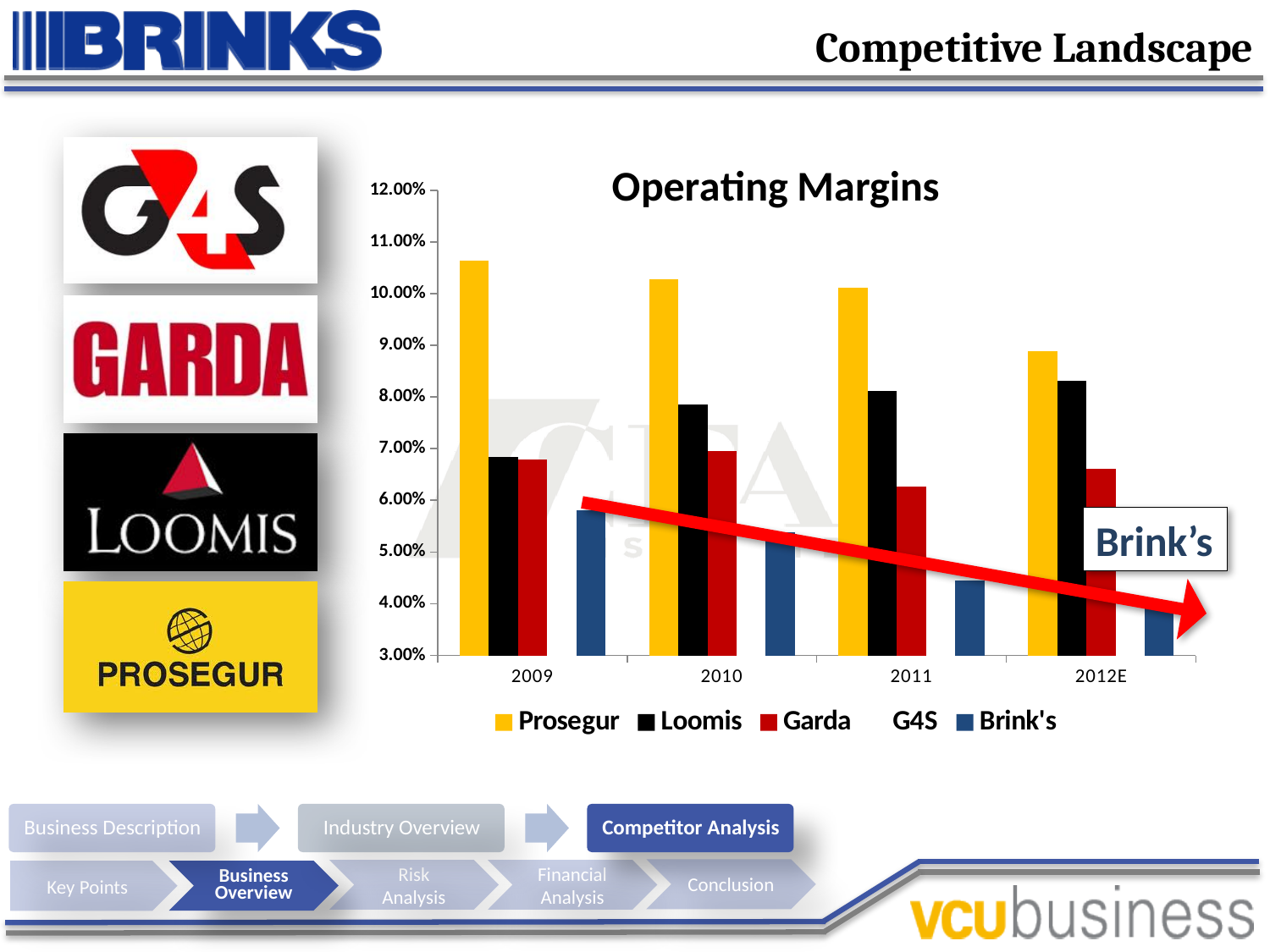
Which company has the highest operating margin in 2012E? Prosegur Which company has the highest operating margin in 2009? Prosegur Is the operating margin for Loomis in 2010 greater or less than 8.00%? less How many series does the chart legend list? 5 Is the operating margin for Brink's in 2011 greater or less than 5.00%? less What kind of chart is shown on the slide? bar chart Does Prosegur's operating margin rise or fall from 2009 to 2012E? fall In 2011, which has the larger operating margin, Loomis or Garda? Loomis Is the operating margin for Prosegur in 2009 greater or less than 10.00%? greater How many year categories are shown on the x axis of the Operating Margins chart? 4 What is the title of the chart? Operating Margins Does Brink's operating margin rise or fall from 2009 to 2012E? fall